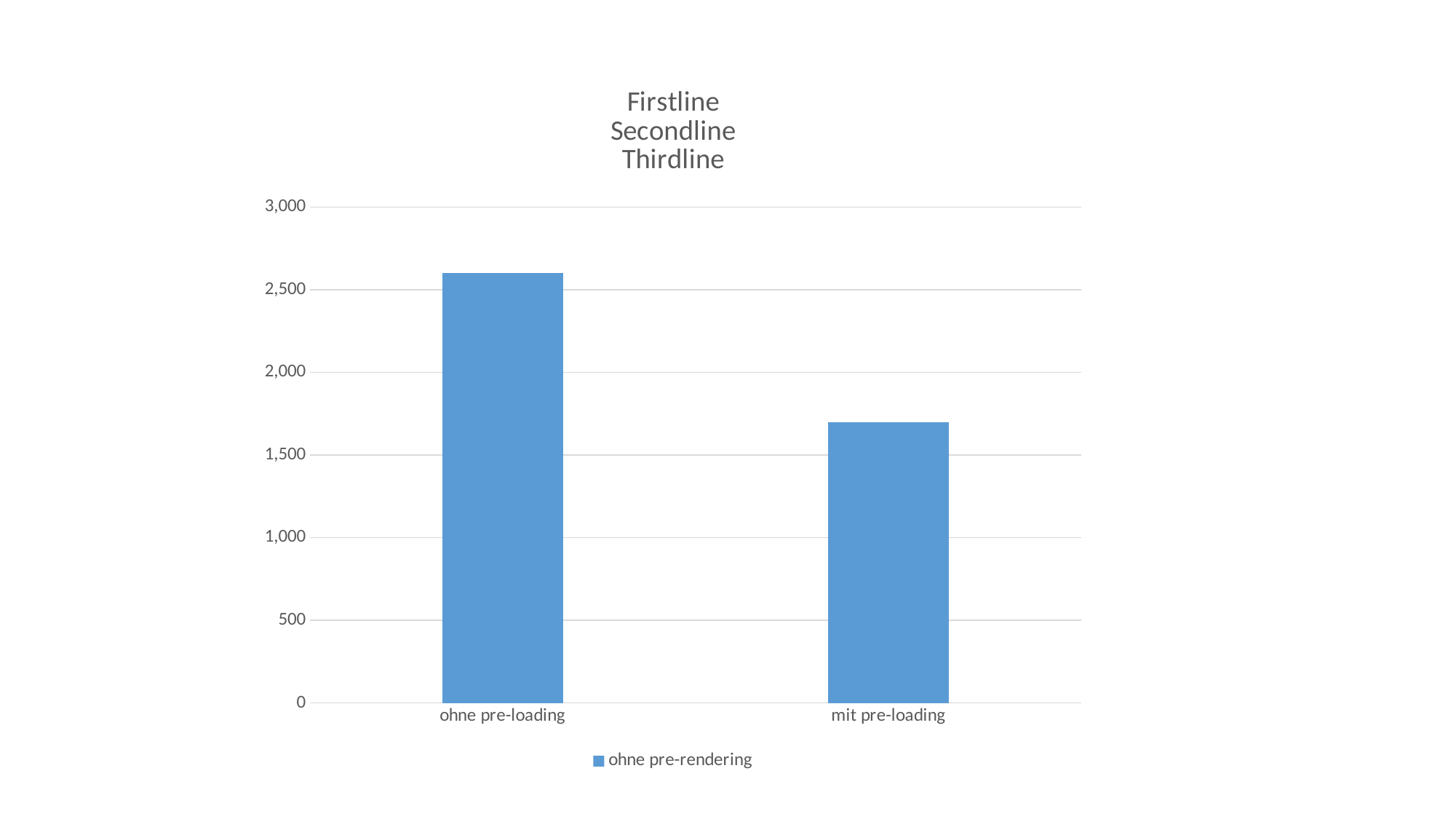
Which category has the lowest value? mit pre-loading Is the value for mit pre-loading greater or less than 1,500? greater Which is larger, the value for ohne pre-loading or the value for mit pre-loading? ohne pre-loading Is the value for ohne pre-loading greater or less than 3,000? less Do the values rise or fall from left to right along the x axis? fall Is the value for mit pre-loading greater or less than 2,000? less What series name is shown in the legend? ohne pre-rendering How many categories are shown on the x axis? 2 How many series does the legend list? 1 What kind of chart is shown on the slide? bar chart Which category has the highest value? ohne pre-loading